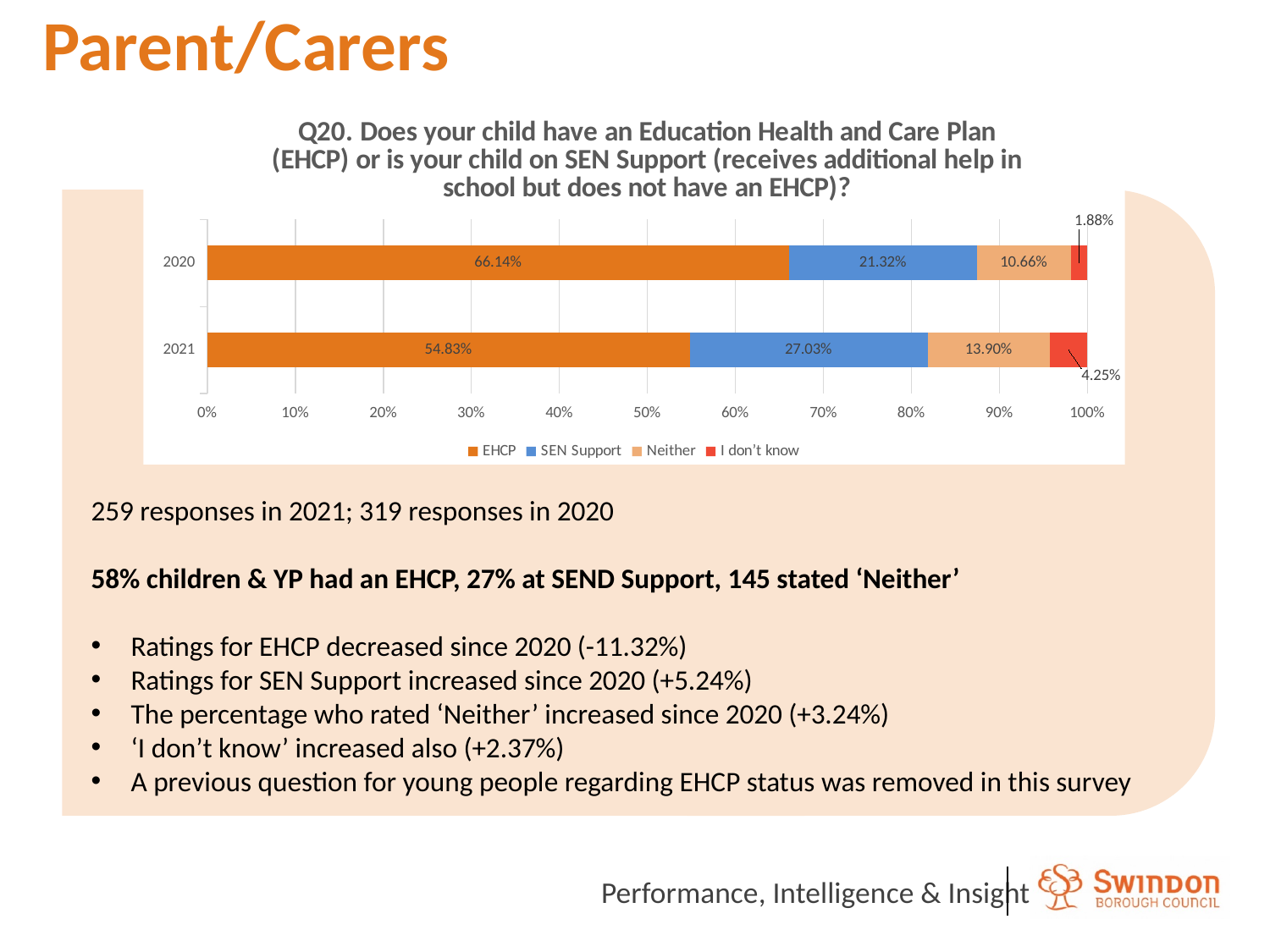
What percentage answered 'Neither' in 2021? 13.90% How many series does the legend list? 4 What is the value for 'I don't know' in 2020? 1.88% What kind of chart is shown on the slide? Stacked bar chart Which year has the higher EHCP percentage, 2020 or 2021? 2020 How many years (categories) are shown on the chart? 2 What is the difference between the EHCP percentages for 2020 and 2021? 11.31% What percentage of parent/carers in 2021 said their child has an EHCP? 54.83% Which series is shown in orange in the chart legend? EHCP Which year has the higher 'I don't know' percentage? 2021 What is the value for SEN Support in 2020? 21.32% What is the difference between the SEN Support percentages for 2021 and 2020? 5.71%